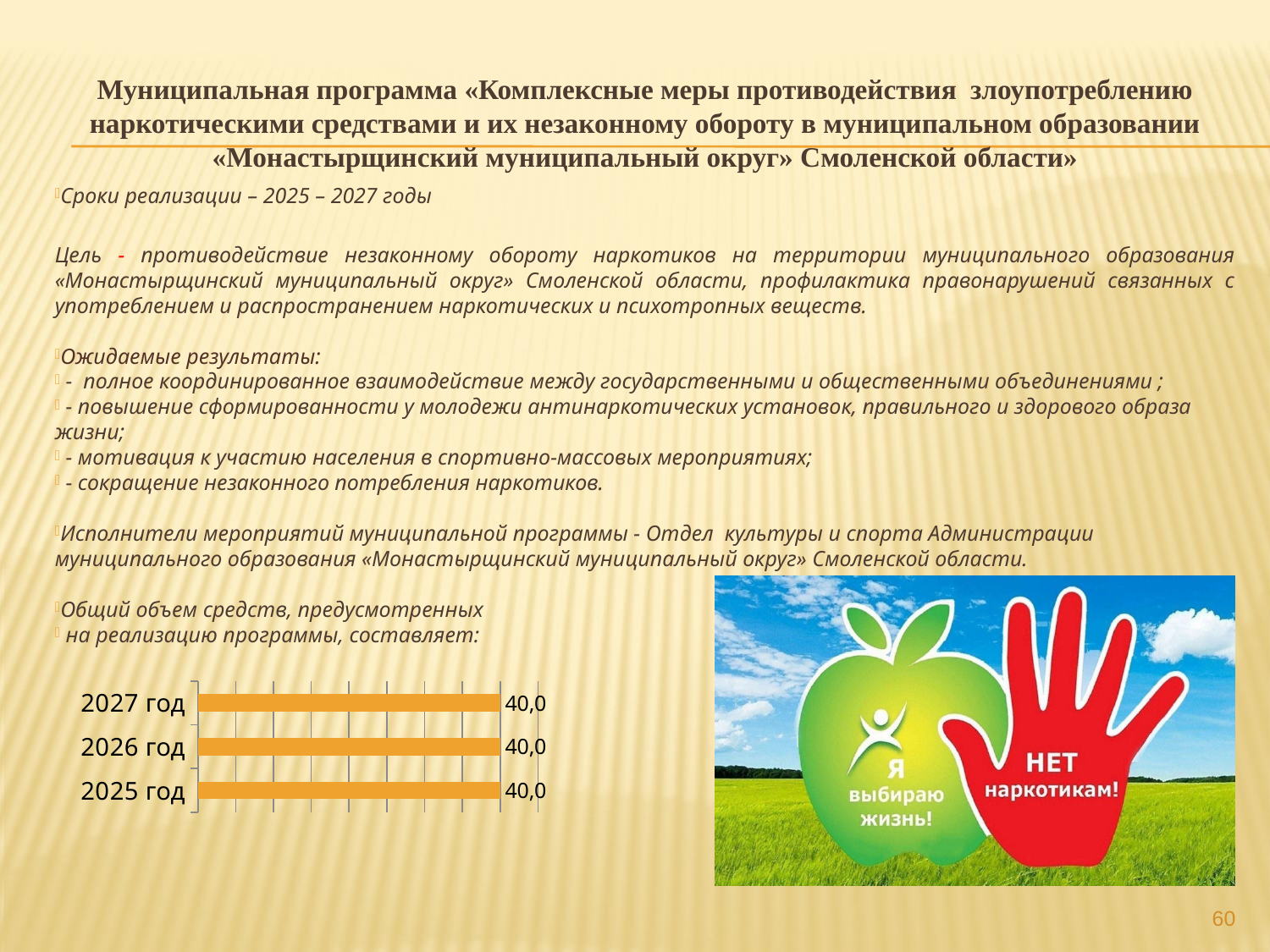
What is the value for 2027 год? 40,0 What is the difference between the values for 2027 год and 2025 год? 0,0 Do the values change from 2025 год to 2027 год, or stay the same? stay the same What colour are the bars in the chart? orange What is the value for 2026 год? 40,0 What kind of chart is shown on the slide? bar chart What is the value for 2025 год? 40,0 What is the total of the values for 2025 год, 2026 год and 2027 год? 120,0 Are the bars in the chart horizontal or vertical? horizontal Which category is listed at the top of the chart? 2027 год How many categories are shown in the chart? 3